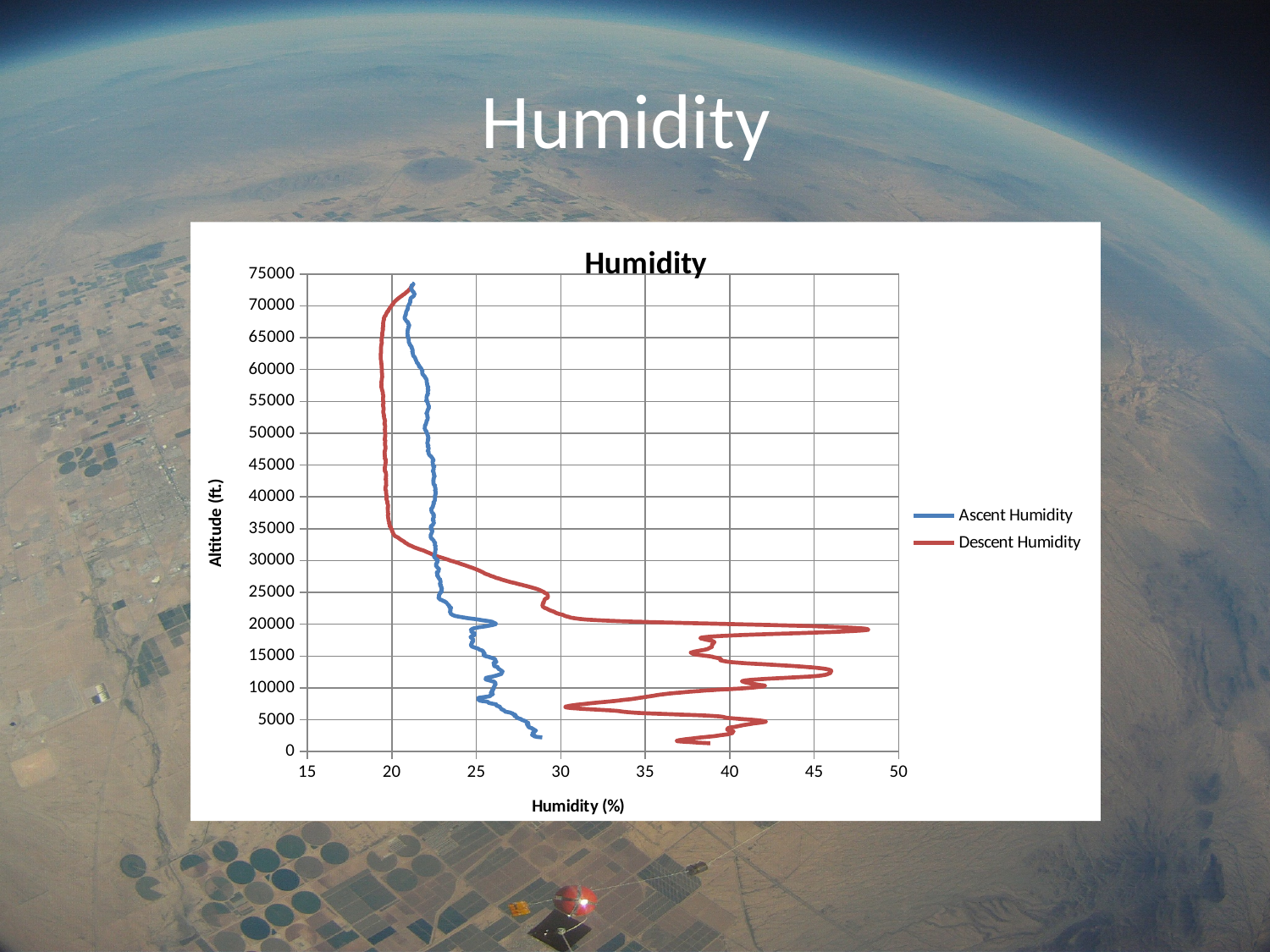
What is the label of the horizontal axis? Humidity (%) At an altitude of 20000 ft, is the Ascent Humidity value greater or less than 30? less Along the Ascent Humidity line, does humidity generally increase or decrease as altitude increases? decrease At an altitude of 20000 ft, which series has the higher humidity, Ascent Humidity or Descent Humidity? Descent Humidity Which series reaches the highest humidity value on the chart? Descent Humidity At an altitude of 40000 ft, is the Descent Humidity value greater or less than 25? less What is the title of the chart? Humidity At an altitude of 60000 ft, which series has the higher humidity, Ascent Humidity or Descent Humidity? Ascent Humidity What kind of chart is shown on the slide? line chart How many series does the legend list? 2 At an altitude of 5000 ft, is the Descent Humidity value greater or less than 35? greater